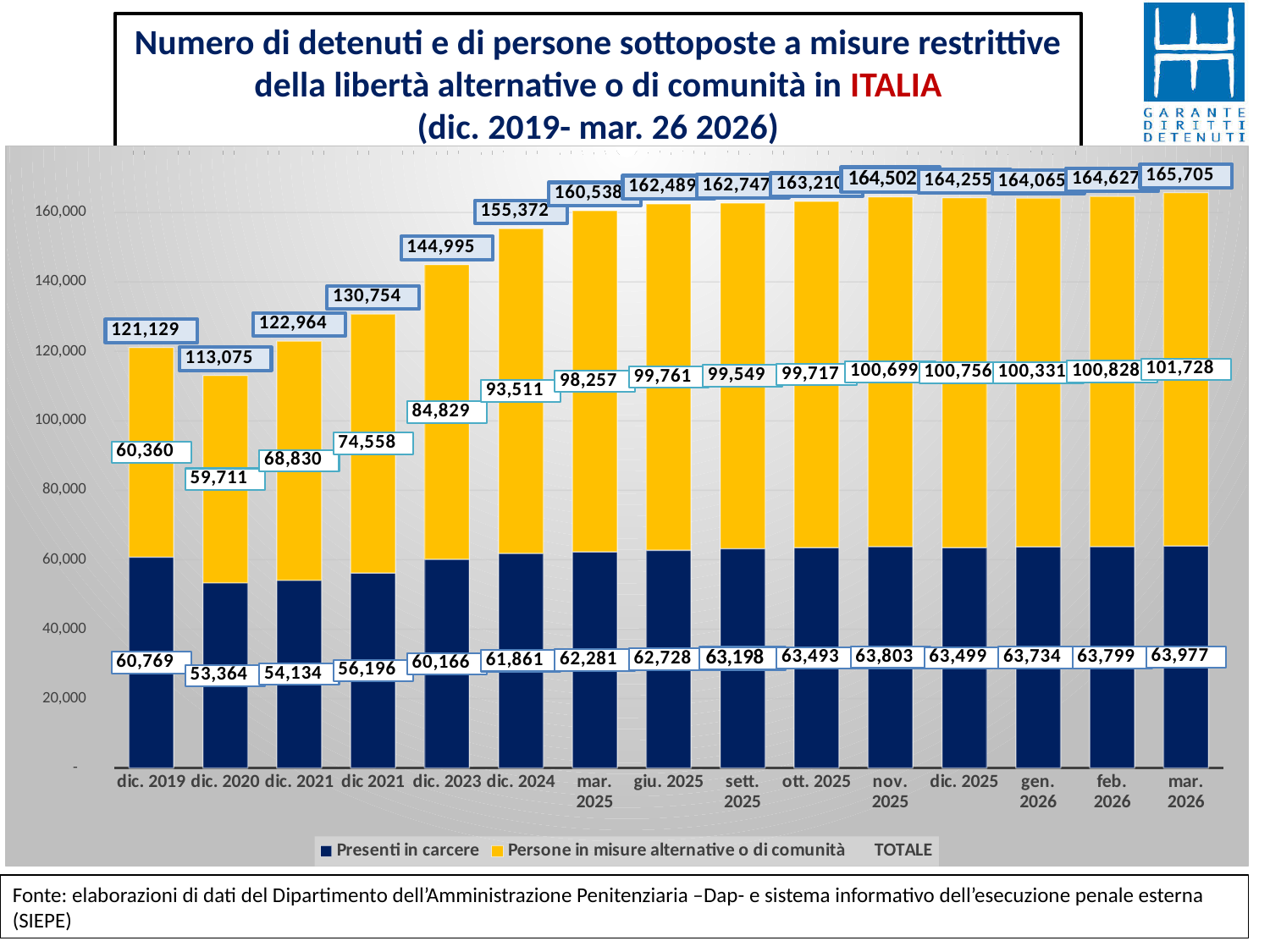
What is the difference between the TOTALE for mar. 2026 and the TOTALE for dic. 2019? 44,576 What is the value of 'Presenti in carcere' for dic. 2019? 60,769 Which period has the lowest value for 'Presenti in carcere'? dic. 2020 How many periods are shown on the x axis? 15 Which period has the highest TOTALE value? mar. 2026 What is the value of 'Presenti in carcere' for nov. 2025? 63,803 What is the value of 'Persone in misure alternative o di comunità' for mar. 2026? 101,728 Which period has the lowest TOTALE value? dic. 2020 How many series does the legend list? 3 For dic. 2019, which is larger: 'Presenti in carcere' or 'Persone in misure alternative o di comunità'? Presenti in carcere Does the value of 'Persone in misure alternative o di comunità' rise or fall from dic. 2019 to mar. 2026? Rise What kind of chart is shown on the slide? Stacked bar chart